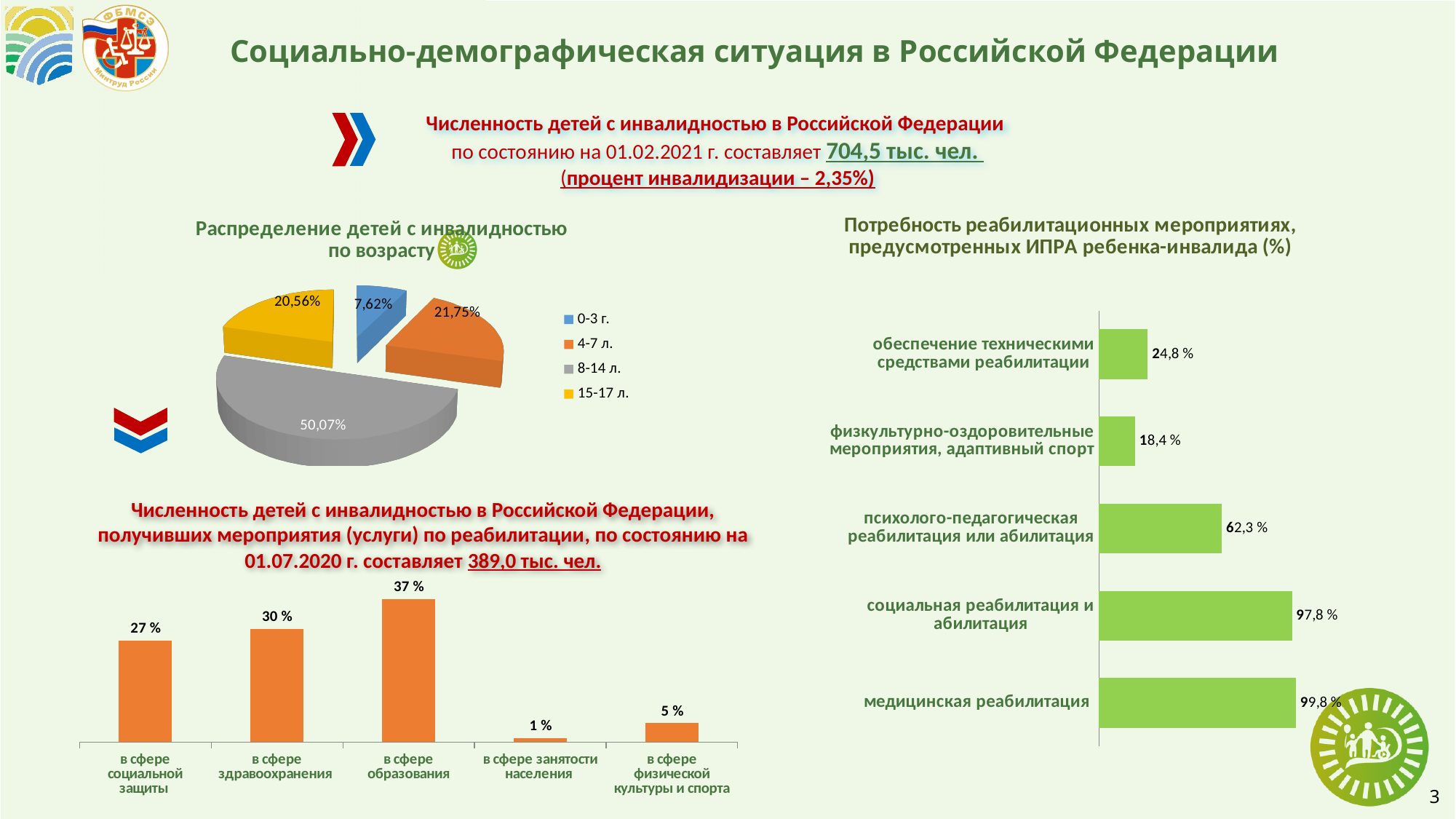
In the bottom-left bar chart, what is the difference between the values for 'в сфере здравоохранения' and 'в сфере социальной защиты'? 3 % In the pie chart 'Распределение детей с инвалидностью по возрасту', which is larger: the share for 4-7 л. or for 15-17 л.? 4-7 л. What kind of chart is 'Потребность реабилитационных мероприятиях, предусмотренных ИПРА ребенка-инвалида (%)'? bar chart In the chart 'Потребность реабилитационных мероприятиях, предусмотренных ИПРА ребенка-инвалида (%)', which category has the highest value? медицинская реабилитация In the pie chart 'Распределение детей с инвалидностью по возрасту', how many age groups does the legend list? 4 How many categories are shown in the bottom-left bar chart? 5 In the bottom-left bar chart, which category has the lowest value? в сфере занятости населения In the chart 'Потребность реабилитационных мероприятиях, предусмотренных ИПРА ребенка-инвалида (%)', what is the value for 'психолого-педагогическая реабилитация или абилитация'? 62,3 % In the pie chart 'Распределение детей с инвалидностью по возрасту', what share is shown for the 8-14 л. age group? 50,07% In the chart 'Потребность реабилитационных мероприятиях, предусмотренных ИПРА ребенка-инвалида (%)', what is the difference between 'обеспечение техническими средствами реабилитации' and 'физкультурно-оздоровительные мероприятия, адаптивный спорт'? 6,4 % In the bottom-left bar chart, what is the value for 'в сфере образования'? 37 % In the pie chart 'Распределение детей с инвалидностью по возрасту', which age group has the smallest share? 0-3 г.